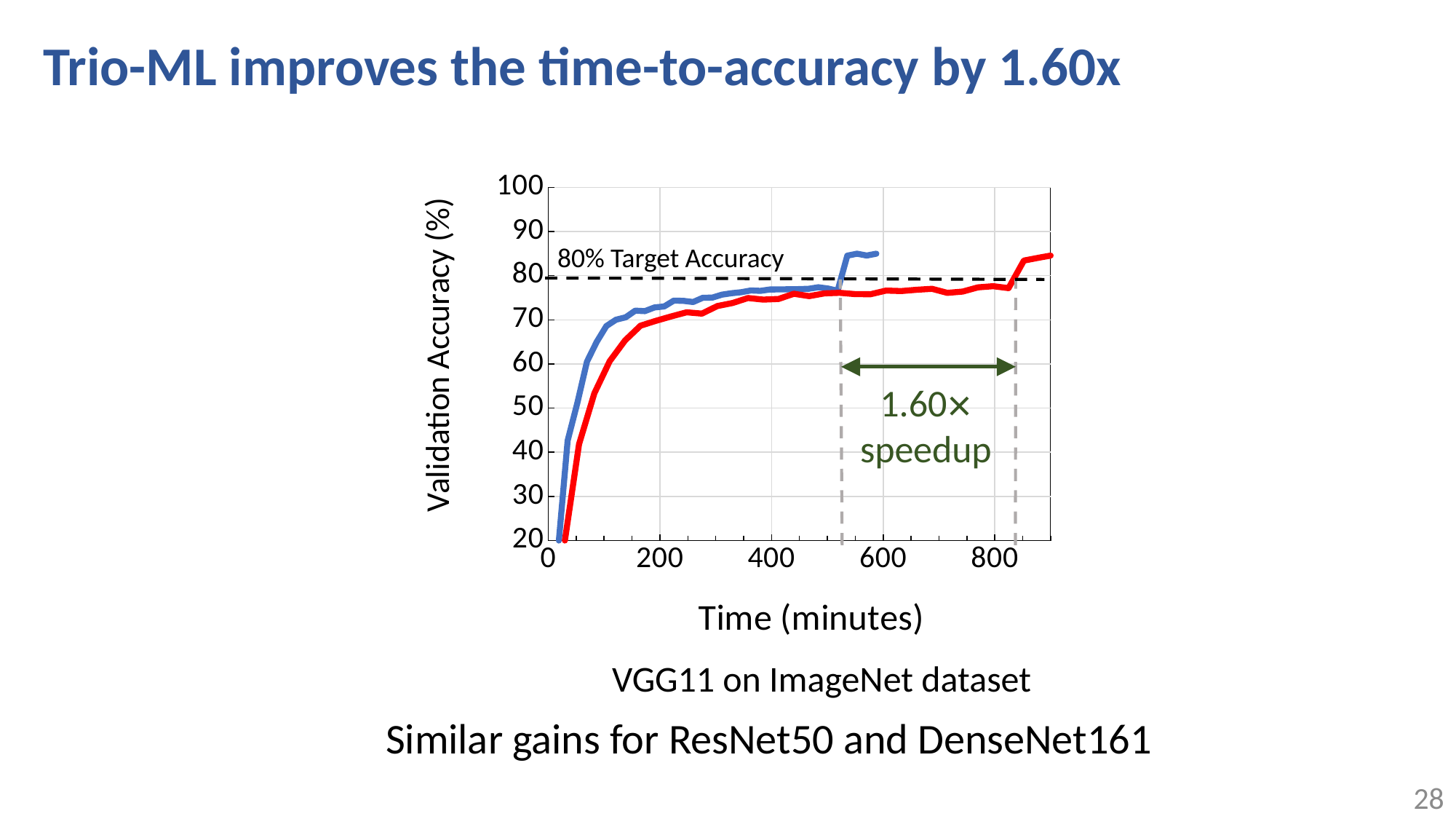
Is the validation accuracy of the blue line at 400 minutes greater or less than 70? greater What speedup is annotated between the two dashed vertical lines? 1.60× speedup How many lines are plotted on the chart? 2 What kind of chart is shown on the slide? line chart What is the label of the x-axis? Time (minutes) Is the validation accuracy of the red line at 600 minutes greater or less than 80? less Which line reaches the 80% target accuracy first, the blue line or the red line? blue line Is the time at which the blue line crosses the 80% target accuracy greater or less than 600 minutes? less What target accuracy does the dashed horizontal line mark? 80% What is the label of the y-axis? Validation Accuracy (%) Do the validation accuracy values generally rise or fall as time increases? rise